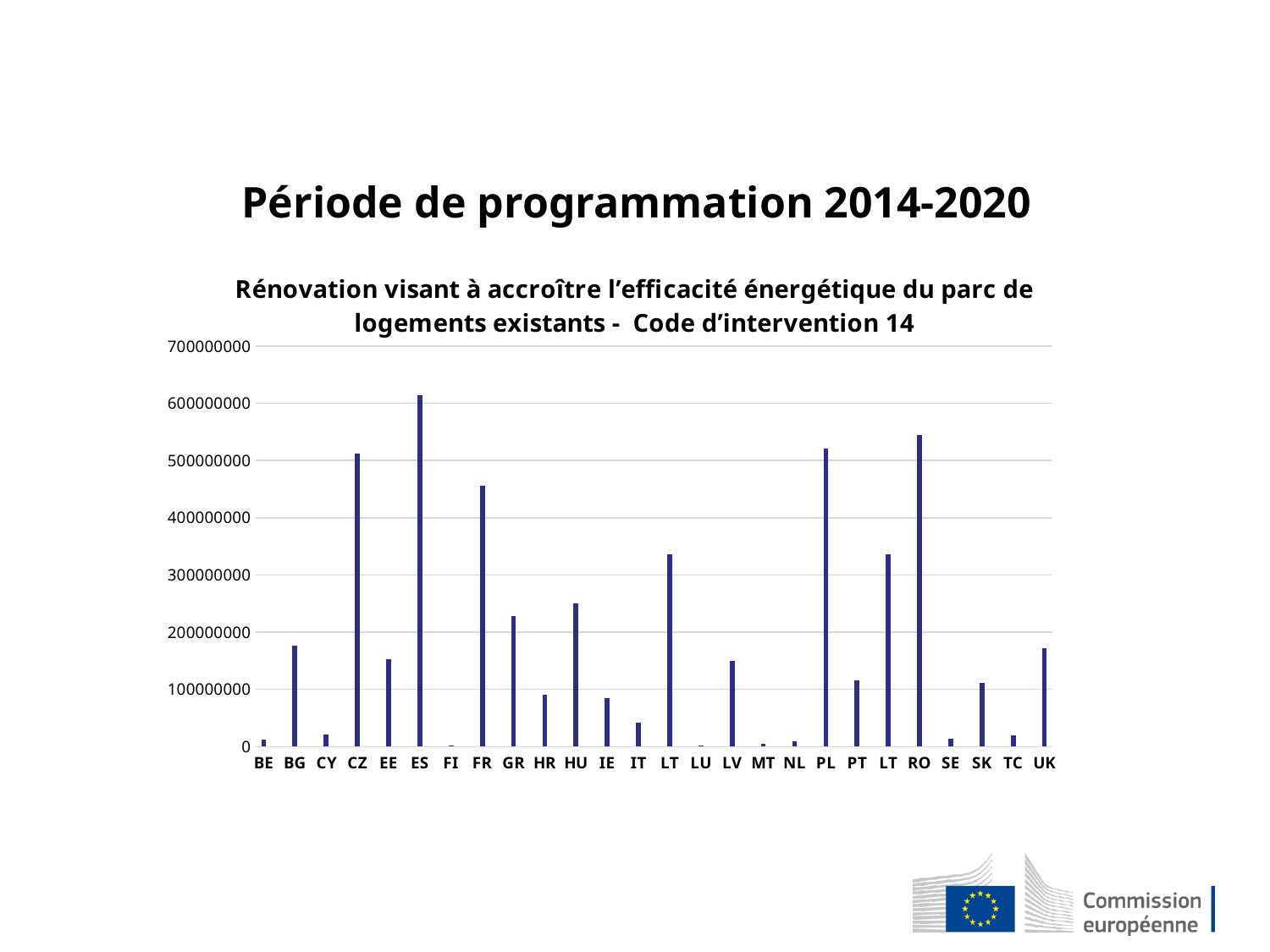
Which is larger, the value for FR or the value for HU? FR Which country has the highest value in the chart? ES Is the value for UK greater or less than 200000000? less Is the value for FR greater or less than 500000000? less Is the value for CZ greater or less than 500000000? greater How many countries (categories) are shown on the x axis of the chart? 26 What kind of chart is shown on the slide? bar chart Which intervention code is named in the chart title? Code d'intervention 14 Which is larger, the value for ES or the value for RO? ES